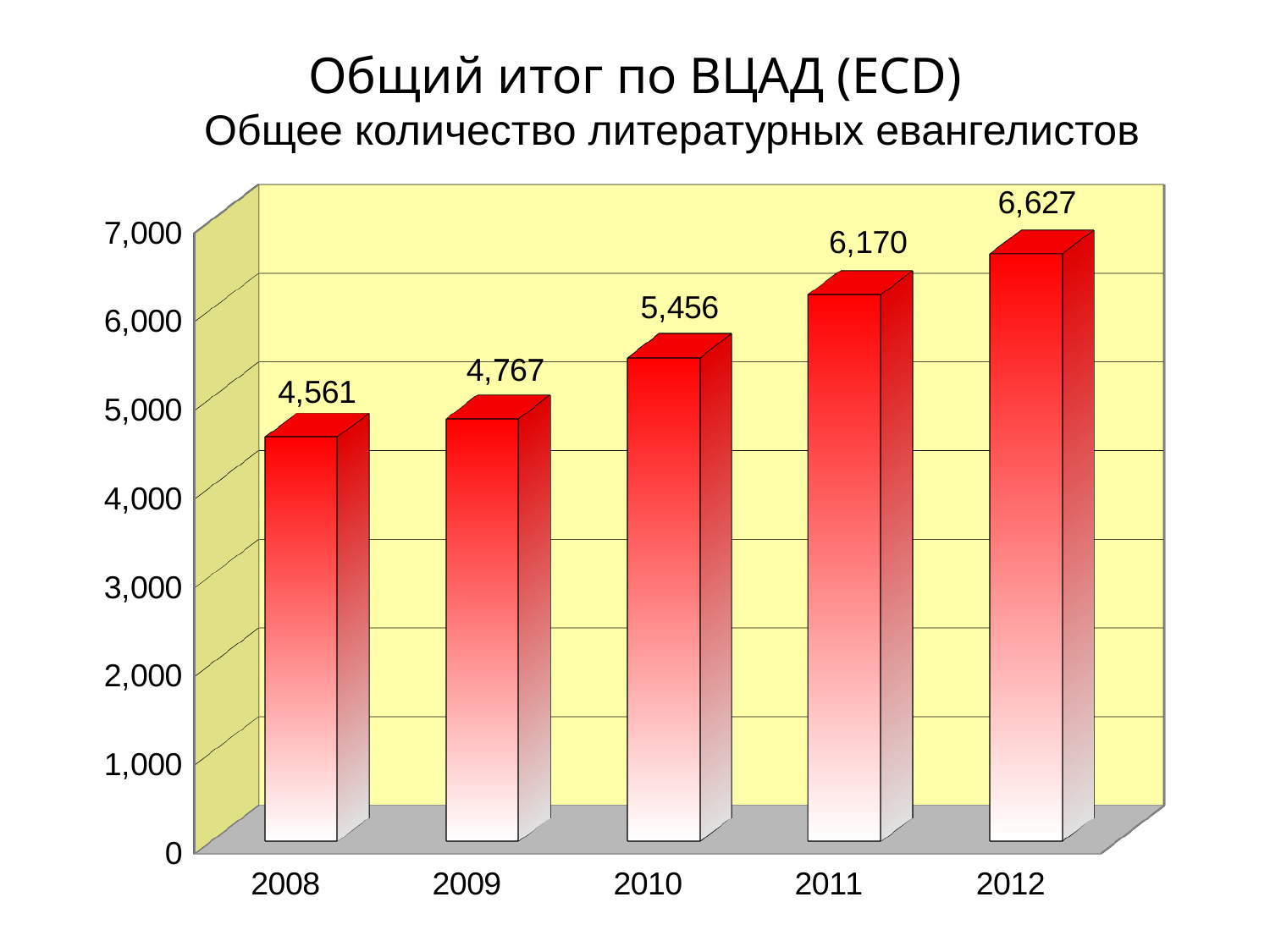
What is the difference between the values for 2011 and 2010? 714 What is the value for 2008? 4,561 What kind of chart is shown on the slide? bar chart Do the values rise or fall from 2008 to 2012? rise Is the value for 2011 greater or less than 6,000? greater What is the difference between the values for 2012 and 2008? 2,066 What is the value for 2012? 6,627 What is the value for 2010? 5,456 How many years are shown on the x axis? 5 Which year has the highest value? 2012 Which is larger, the value for 2009 or the value for 2011? 2011 Which year has the lowest value? 2008